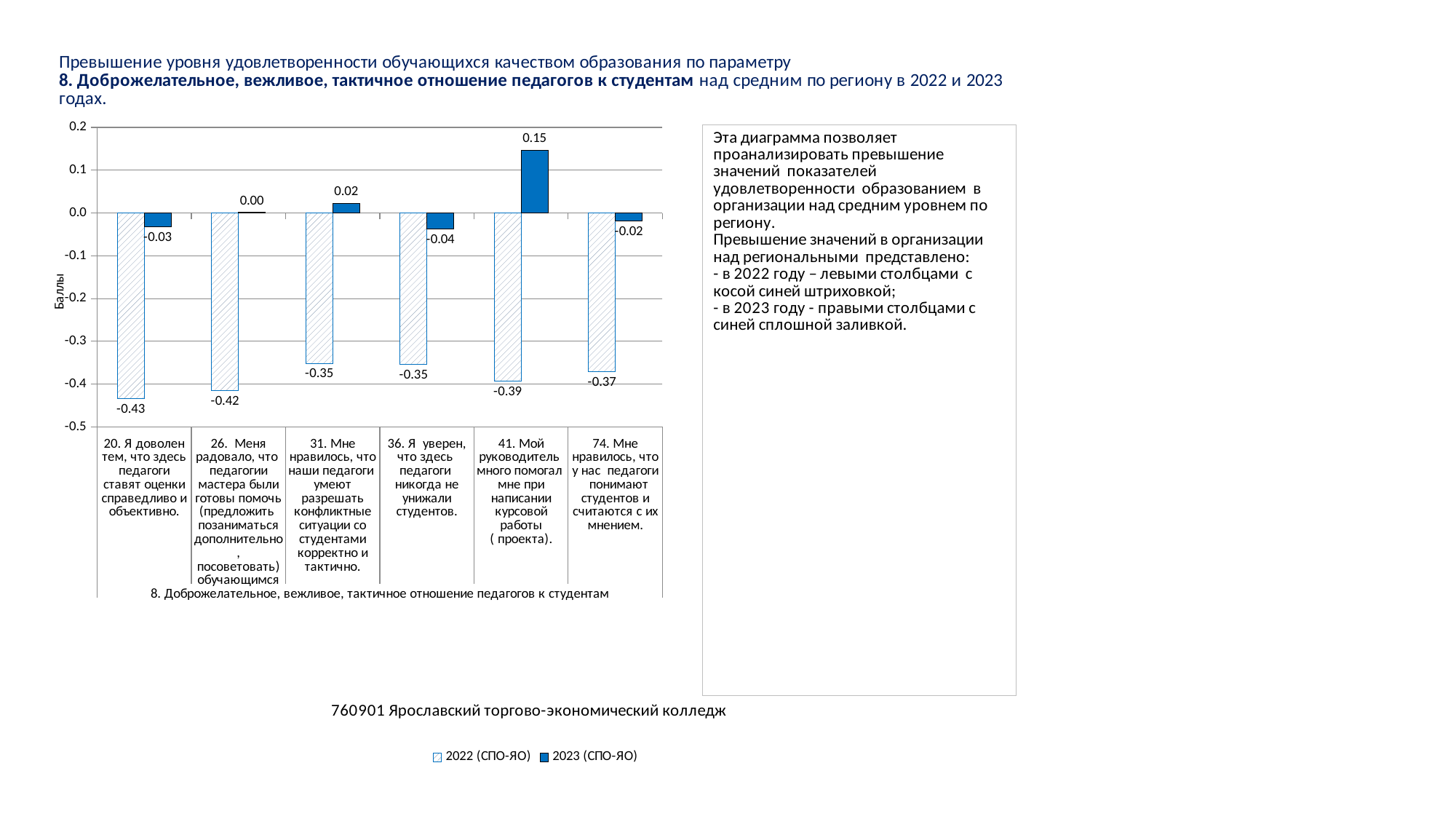
What is the 2022 (СПО-ЯО) value for category 74 (Мне нравилось, что у нас педагоги понимают студентов и считаются с их мнением)? -0.37 Which category has the highest 2023 (СПО-ЯО) value? 41. Мой руководитель много помогал мне при написании курсовой работы (проекта). What is the label of the y axis of the chart? Баллы How many categories are shown on the x axis of the chart? 6 What is the 2023 (СПО-ЯО) value for category 26 (Меня радовало, что педагоги мастера были готовы помочь)? 0.00 What kind of chart is shown on the slide? Bar chart Which is larger for category 36: the 2022 (СПО-ЯО) value or the 2023 (СПО-ЯО) value? 2023 (СПО-ЯО) What is the 2023 (СПО-ЯО) value for category 41 (Мой руководитель много помогал мне при написании курсовой работы)? 0.15 What is the difference between the 2023 and 2022 values for category 41? 0.54 What is the 2022 (СПО-ЯО) value for category 20 (Я доволен тем, что здесь педагоги ставят оценки справедливо и объективно)? -0.43 Which category has the lowest 2022 (СПО-ЯО) value? 20. Я доволен тем, что здесь педагоги ставят оценки справедливо и объективно. How many series does the legend list? 2